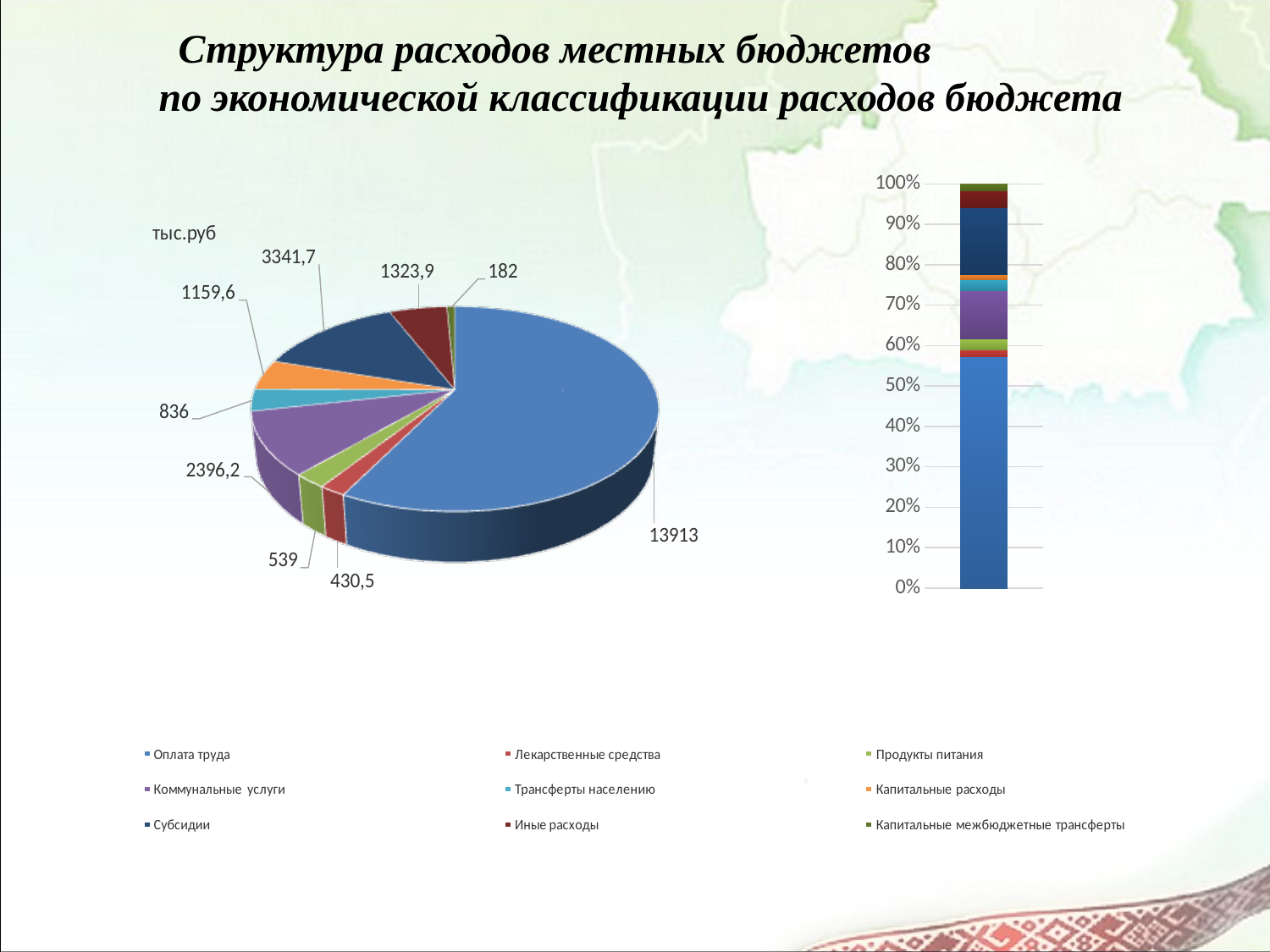
What unit is shown above the pie chart? тыс.руб What kind of chart is the chart on the left of the slide? Pie chart In the pie chart, what is the difference between the values for Субсидии and Иные расходы? 2017,8 How many categories does the legend list? 9 In the stacked bar chart on the right, is the share of Оплата труда greater or less than 50%? greater In the pie chart, which category has the largest value? Оплата труда In the pie chart, which is larger: Продукты питания or Лекарственные средства? Продукты питания In the pie chart, which category has the smallest value? Капитальные межбюджетные трансферты In the pie chart, what is the value for Капитальные межбюджетные трансферты? 182 In the pie chart, what is the value for Коммунальные услуги? 2396,2 In the pie chart, what is the value for Субсидии? 3341,7 In the pie chart, what is the value for Оплата труда? 13913